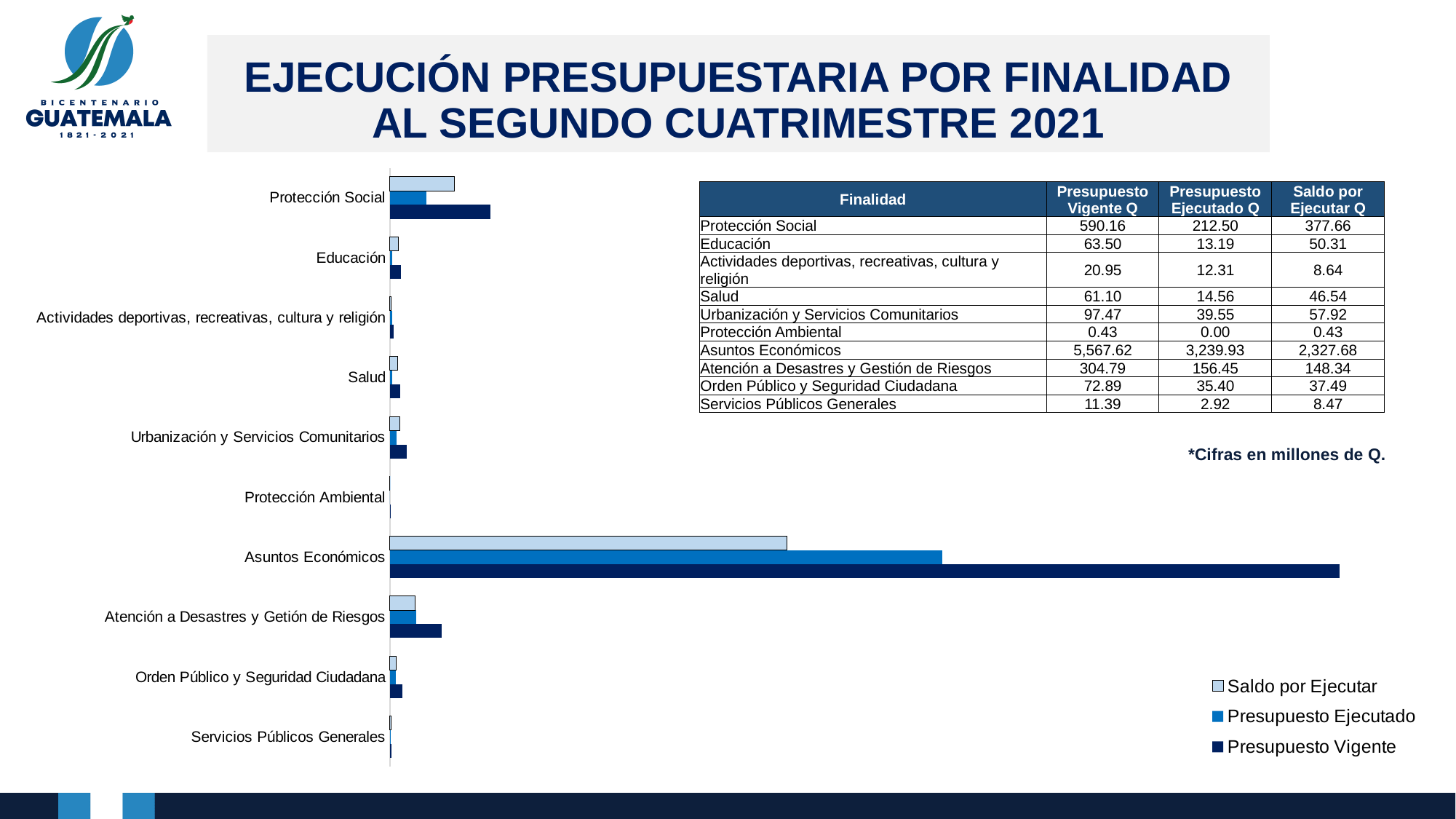
How many series does the chart legend list? 3 What kind of chart is shown on the slide? bar chart Which has a larger Presupuesto Vigente: Atención a Desastres y Gestión de Riesgos or Urbanización y Servicios Comunitarios? Atención a Desastres y Gestión de Riesgos What is the difference between the Presupuesto Vigente and the Presupuesto Ejecutado for Salud? 46.54 What is the Saldo por Ejecutar for Urbanización y Servicios Comunitarios? 57.92 Which series is shown in the darkest blue in the legend? Presupuesto Vigente Which category has the highest Presupuesto Vigente? Asuntos Económicos How many categories (finalidades) does the chart show? 10 What is the Presupuesto Ejecutado for Asuntos Económicos? 3,239.93 What is the Presupuesto Ejecutado for Protección Ambiental? 0.00 What is the Presupuesto Vigente for Protección Social? 590.16 Which category has the lowest Presupuesto Vigente? Protección Ambiental